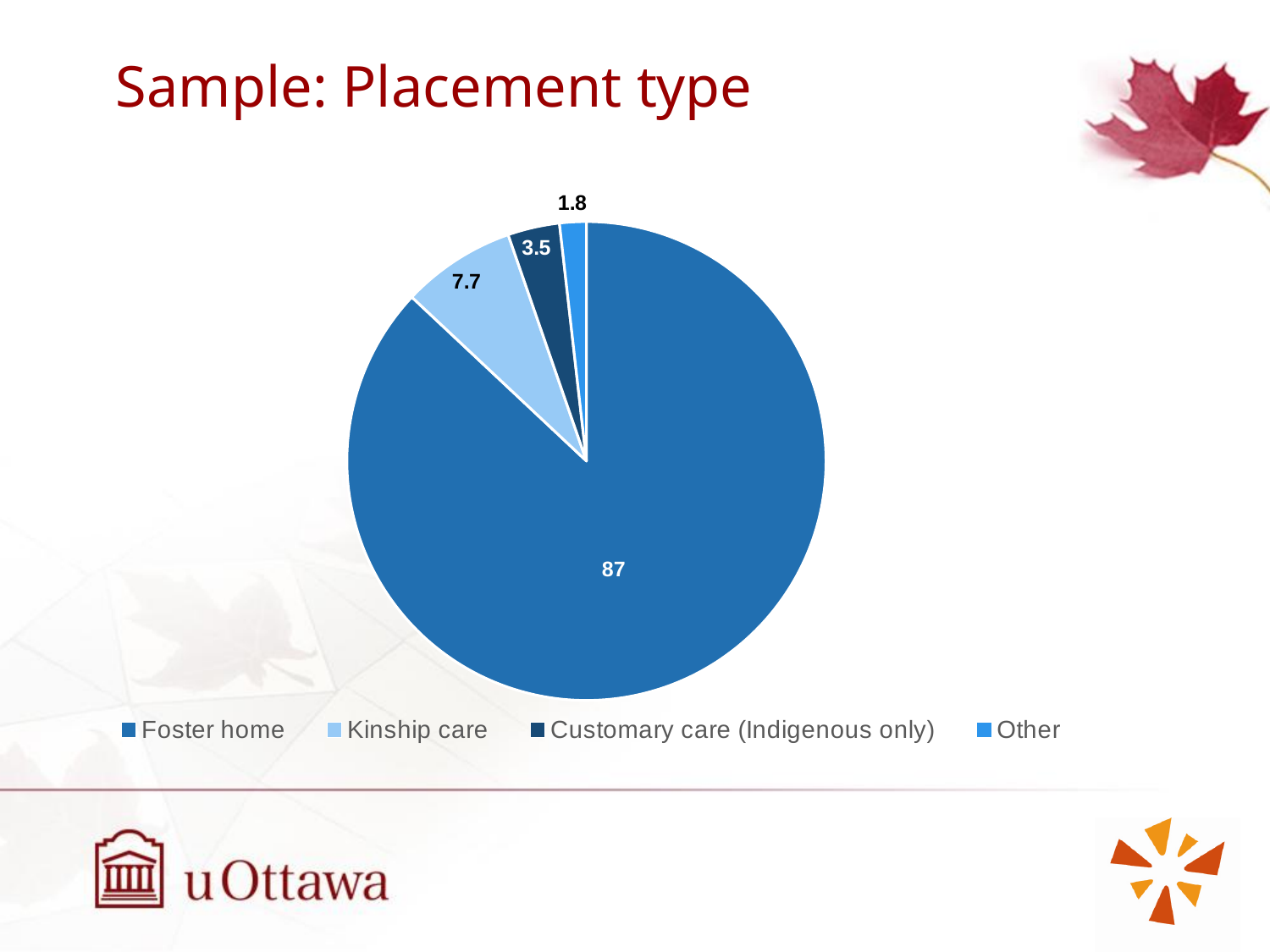
What is the difference between the Kinship care value and the Customary care (Indigenous only) value? 4.2 How many slices does the pie chart have? 4 What is the value shown for the Foster home slice? 87 What is the difference between the Foster home value and the Kinship care value? 79.3 What is the title of the slide containing the chart? Sample: Placement type What type of chart is shown on the slide? Pie chart What is the value shown for the Other slice? 1.8 Which placement type has the smallest slice of the pie? Other Which is larger, the Customary care (Indigenous only) slice or the Other slice? Customary care (Indigenous only) What is the value shown for the Kinship care slice? 7.7 What is the value shown for the Customary care (Indigenous only) slice? 3.5 Which placement type has the largest slice of the pie? Foster home